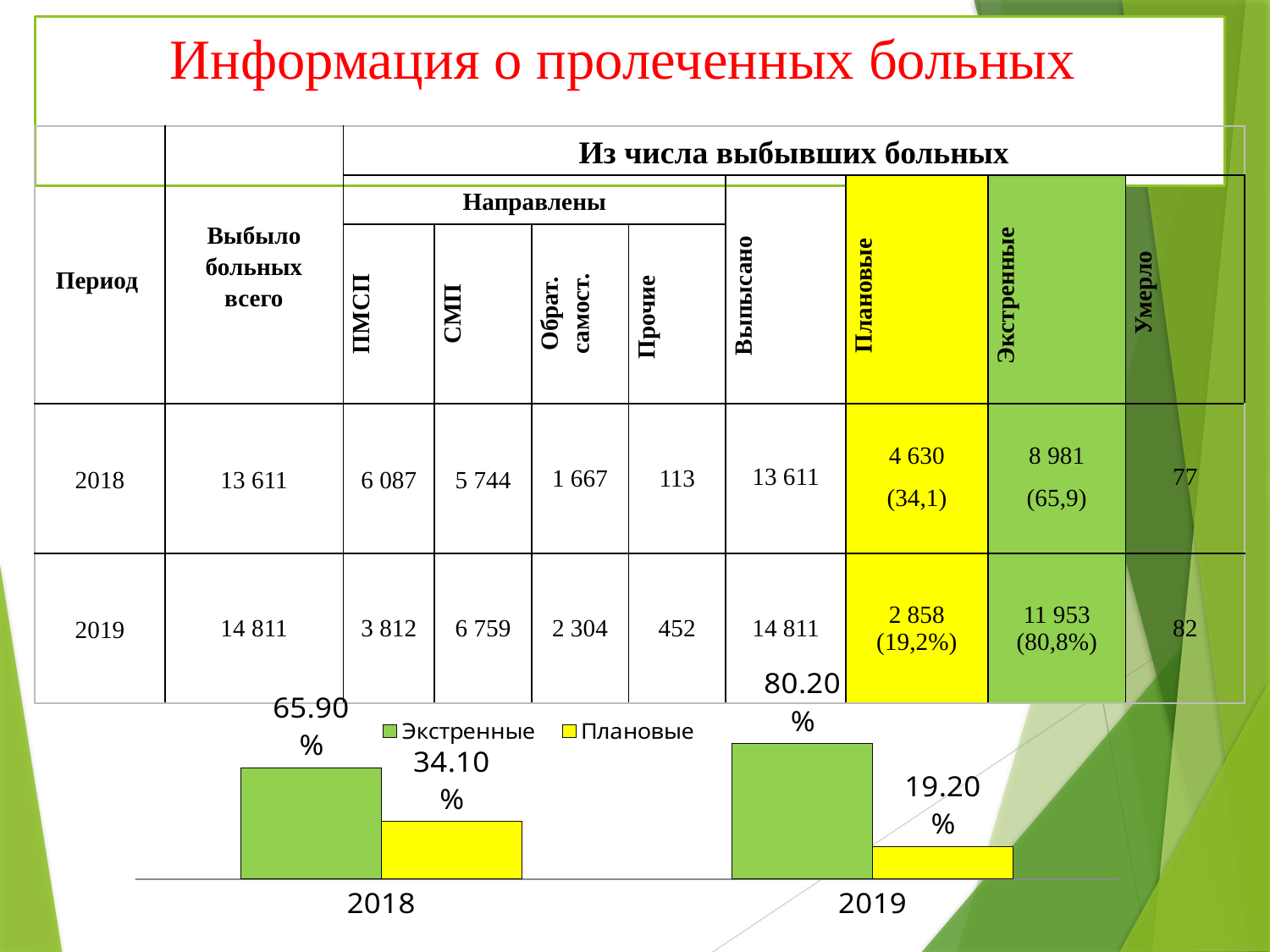
How many categories (years) are shown on the chart's x axis? 2 What are the two series named in the chart legend? Экстренные and Плановые What is the value of Экстренные for 2018 in the chart? 65.90% What is the value of Плановые for 2019 in the chart? 19.20% In the chart, which year has the lower Плановые value? 2019 What type of chart is shown at the bottom of the slide? bar chart How many series does the chart legend list? 2 What is the value of Экстренные for 2019 in the chart? 80.20% Does the Плановые series rise or fall from 2018 to 2019 in the chart? fall In the chart, what is the difference between the Экстренные values for 2019 and 2018? 14.30% What is the value of Плановые for 2018 in the chart? 34.10% In the chart, which year has the higher Экстренные value? 2019